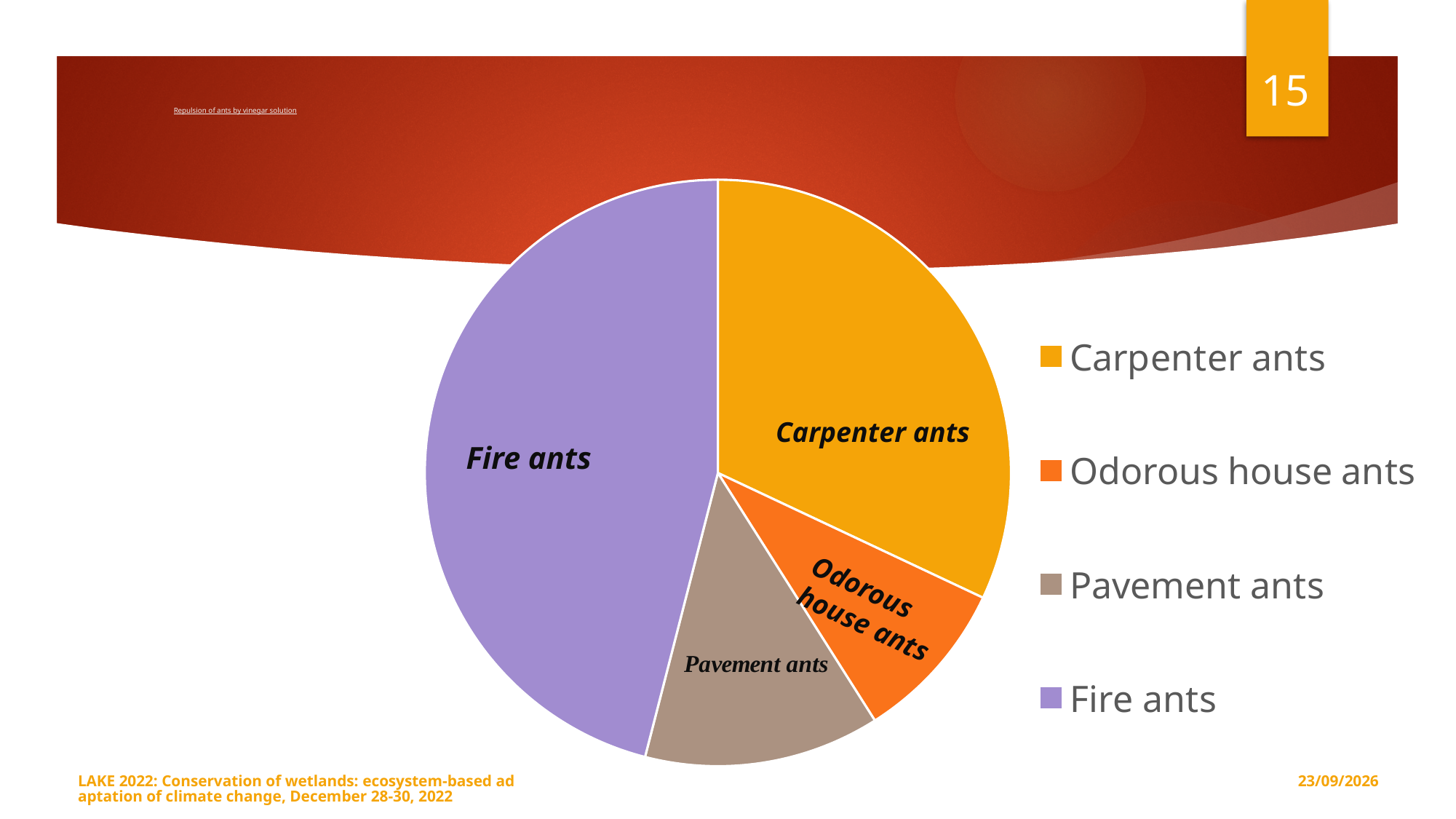
Which ant type has the smallest slice of the pie chart? Odorous house ants How many slices does the pie chart have? 4 How many entries does the legend of the pie chart list? 4 Which slice is larger, Carpenter ants or Pavement ants? Carpenter ants Which slice is larger, Pavement ants or Odorous house ants? Pavement ants What kind of chart is shown on the slide? Pie chart Which ant type has the largest slice of the pie chart? Fire ants What colour is the Fire ants slice in the pie chart? Purple Which slice is larger, Fire ants or Carpenter ants? Fire ants